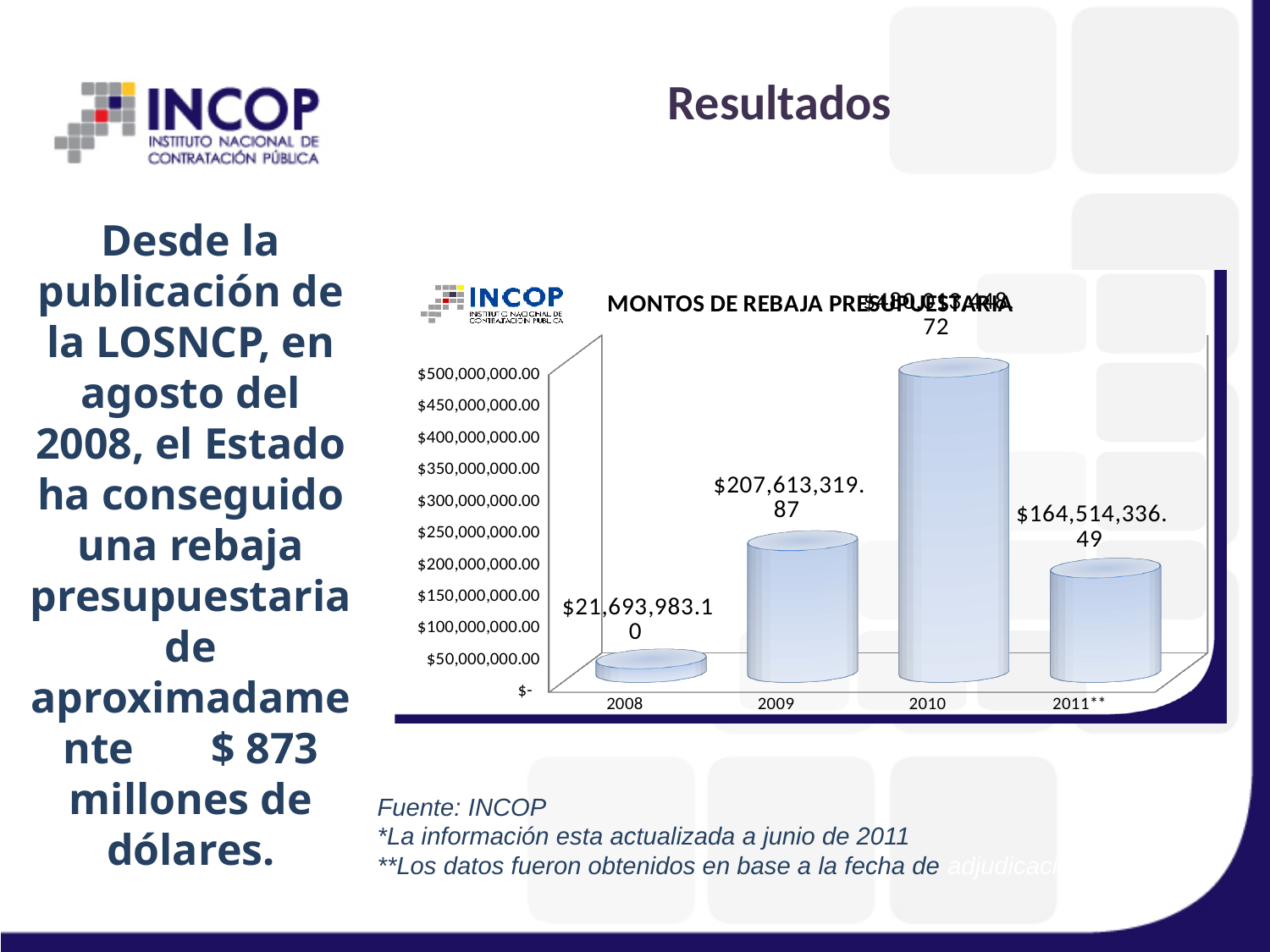
What is the value shown for 2009? $207,613,319.87 How many years are shown on the x axis of the chart? 4 What is the difference between the values for 2009 and 2011**? $43,098,983.38 What is the title of the chart? MONTOS DE REBAJA PRESUPUESTARIA Which is larger, the value for 2009 or the value for 2011**? 2009 Which year has the lowest value in the chart? 2008 What is the value shown for 2011**? $164,514,336.49 Is the value for 2010 greater or less than $400,000,000.00? greater What kind of chart is shown on the slide? Bar chart Which year has the highest value in the chart? 2010 What is the value shown for 2008? $21,693,983.10 Do the values rise or fall from 2008 to 2010? Rise